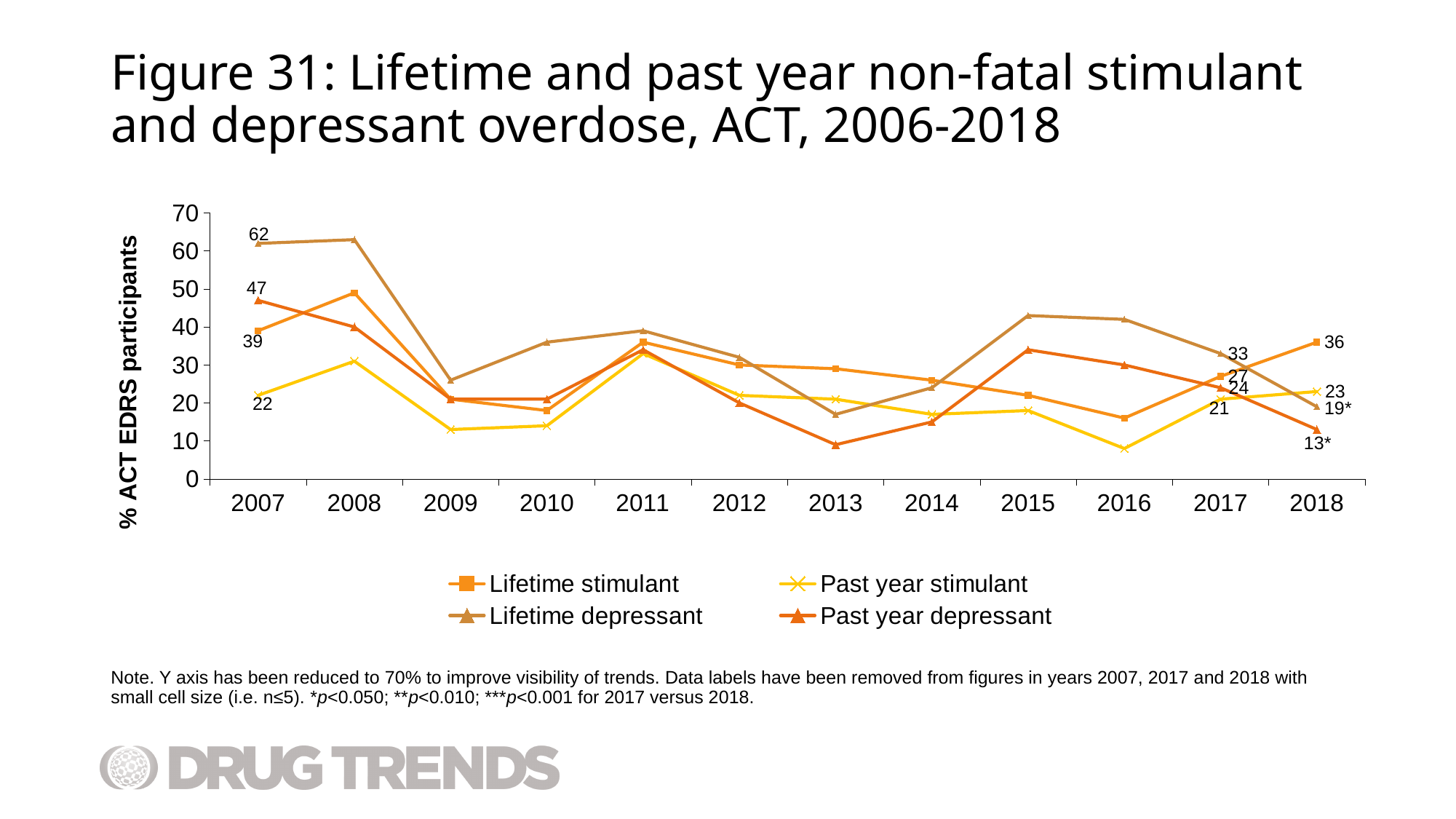
What is the value for Past year stimulant in 2017? 21 What is the value for Lifetime stimulant in 2018? 36 By how much did Lifetime stimulant increase from 2017 to 2018? 9 Which series has the highest value in 2018? Lifetime stimulant What is the value for Past year stimulant in 2018? 23 Is the value for Past year stimulant in 2016 greater or less than 10? less What is the difference between Lifetime depressant and Lifetime stimulant in 2007? 23 What is the value for Lifetime depressant in 2007? 62 What is the value for Past year depressant in 2018? 13* How many series does the legend list? 4 In 2007, which is larger: Lifetime depressant or Past year depressant? Lifetime depressant Is the value for Lifetime depressant in 2015 greater or less than 40? greater